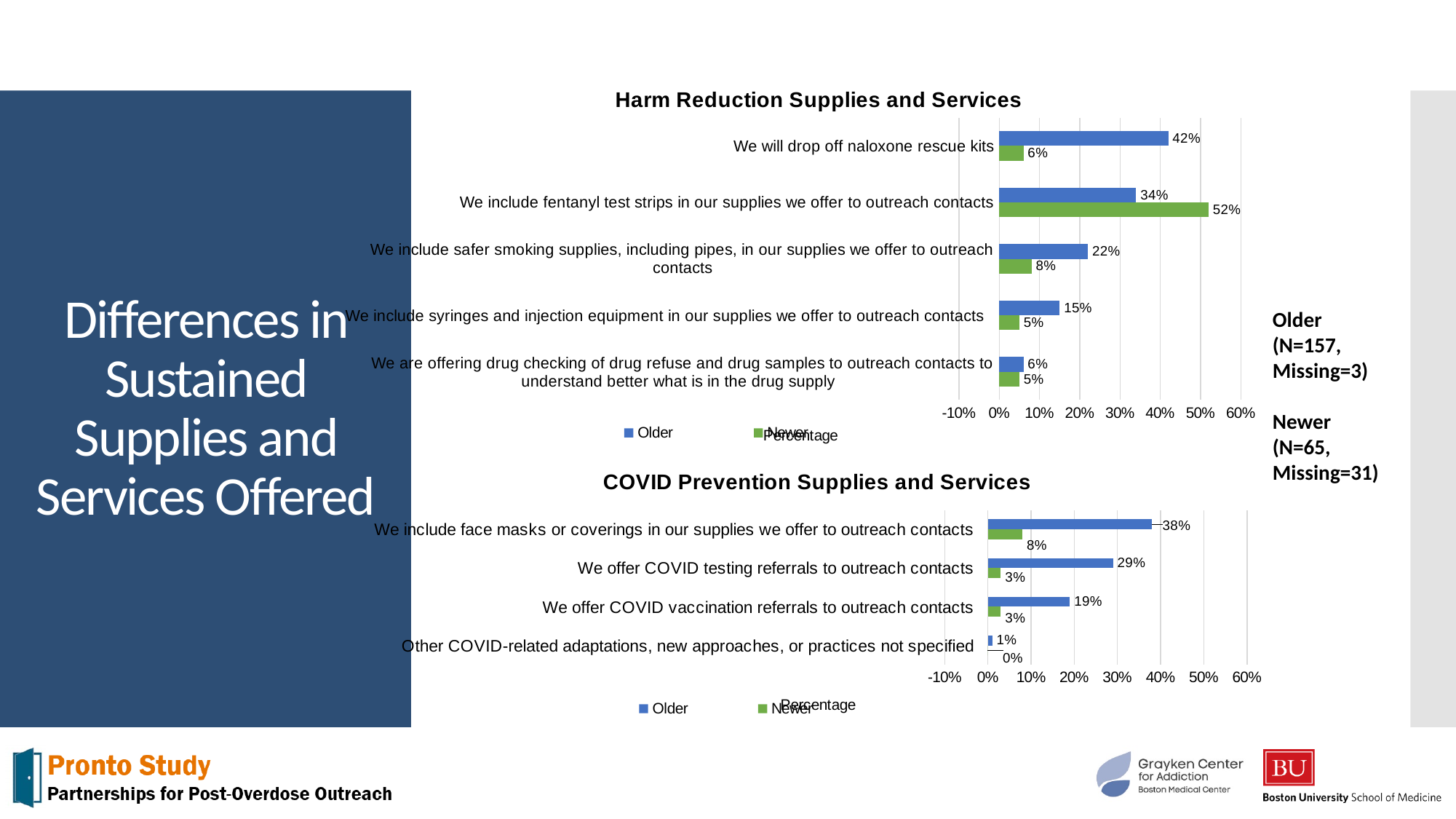
In the Harm Reduction Supplies and Services chart, what is the Newer value for "We include fentanyl test strips in our supplies we offer to outreach contacts"? 52% In the Harm Reduction Supplies and Services chart, what is the Older value for "We will drop off naloxone rescue kits"? 42% In the COVID Prevention Supplies and Services chart, what is the Older value for "We offer COVID testing referrals to outreach contacts"? 29% In the Harm Reduction Supplies and Services chart, is the Older value for safer smoking supplies larger or smaller than the Newer value? larger How many categories are shown in the Harm Reduction Supplies and Services chart? 5 In the COVID Prevention Supplies and Services chart, which category has the lowest Older value? Other COVID-related adaptations, new approaches, or practices not specified In the COVID Prevention Supplies and Services chart, what is the difference between the Older and Newer values for COVID vaccination referrals? 16% How many series does the legend of the COVID Prevention Supplies and Services chart list? 2 In the Harm Reduction Supplies and Services chart, which category has the highest Older value? We will drop off naloxone rescue kits In the COVID Prevention Supplies and Services chart, what is the Newer value for "We include face masks or coverings in our supplies we offer to outreach contacts"? 8% In the Harm Reduction Supplies and Services chart, what is the difference between the Newer and Older values for the fentanyl test strips category? 18% What type of chart is the Harm Reduction Supplies and Services chart? bar chart